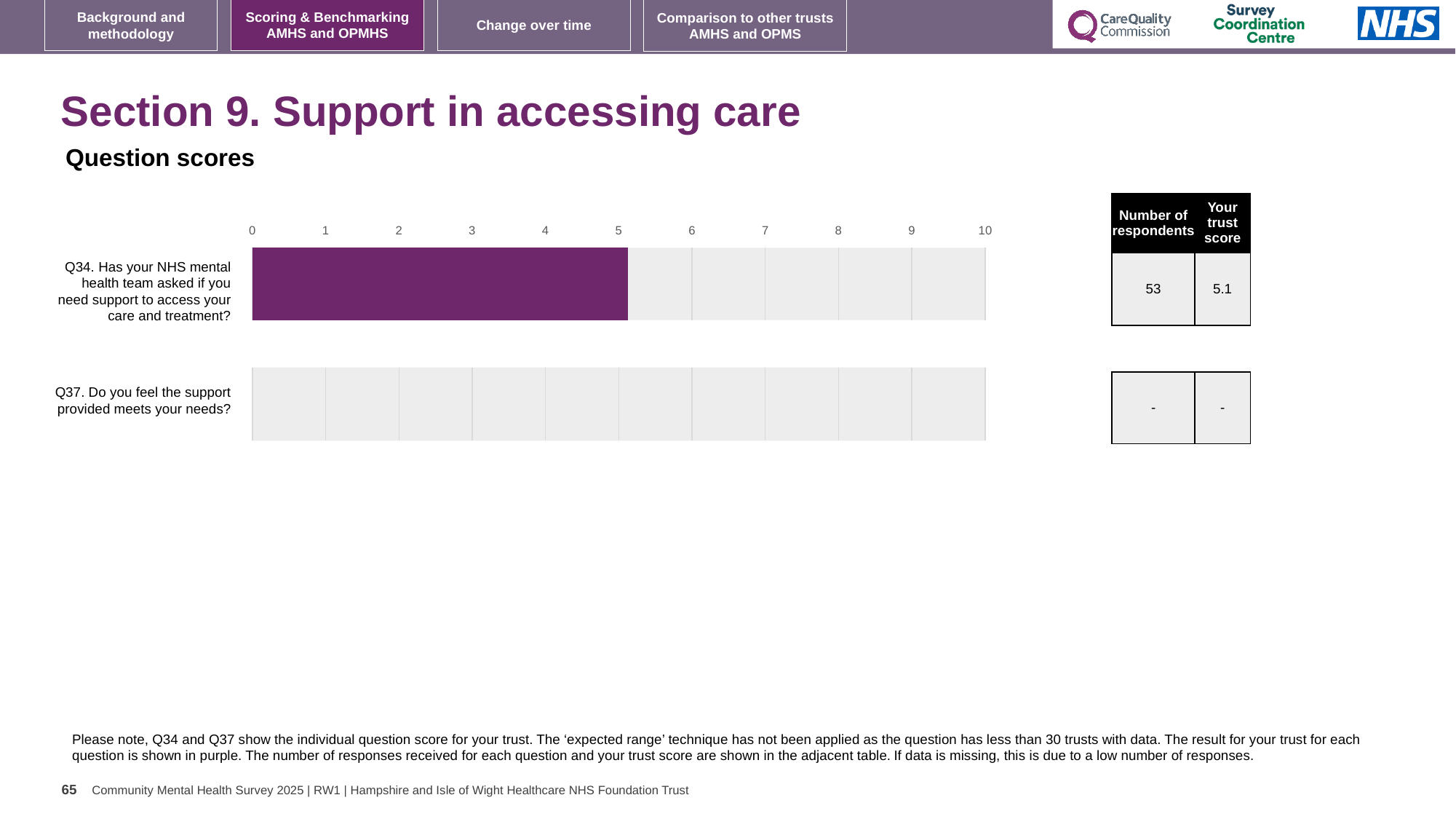
How many questions (categories) are listed on the chart? 2 What colour is the bar for Q34? purple Is the value for Q34 greater or less than 4? greater What is the trust score shown for Q37 (Do you feel the support provided meets your needs?)? - Which question on the chart has no bar plotted? Q37 Is the value for Q34 greater or less than 6? less How many respondents answered Q34? 53 What is the maximum value shown on the chart's axis? 10 What kind of chart is shown on the slide? bar chart What is the trust score for Q34 (Has your NHS mental health team asked if you need support to access your care and treatment?)? 5.1